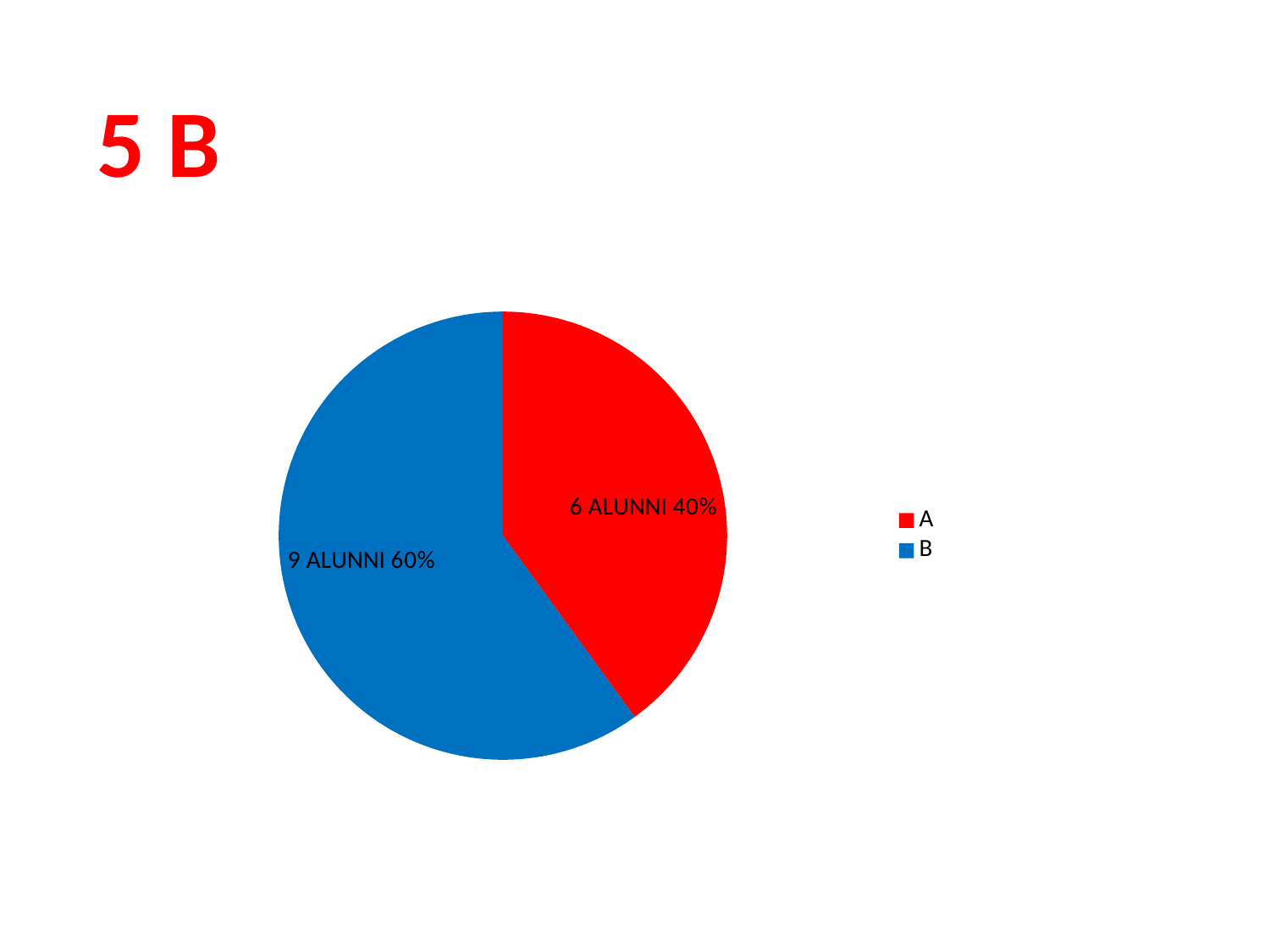
Which is larger, slice A or slice B? B What is the difference in number of alunni between slice B and slice A? 3 How many alunni are in slice B? 9 What share of the pie does slice A represent? 40% How many entries does the legend list? 2 Which slice is the smallest? A How many slices does the pie chart have? 2 What colour is slice A in the pie chart? red What share of the pie does slice B represent? 60% How many alunni are in slice A? 6 What kind of chart is shown on the slide? pie chart Which slice is the largest? B